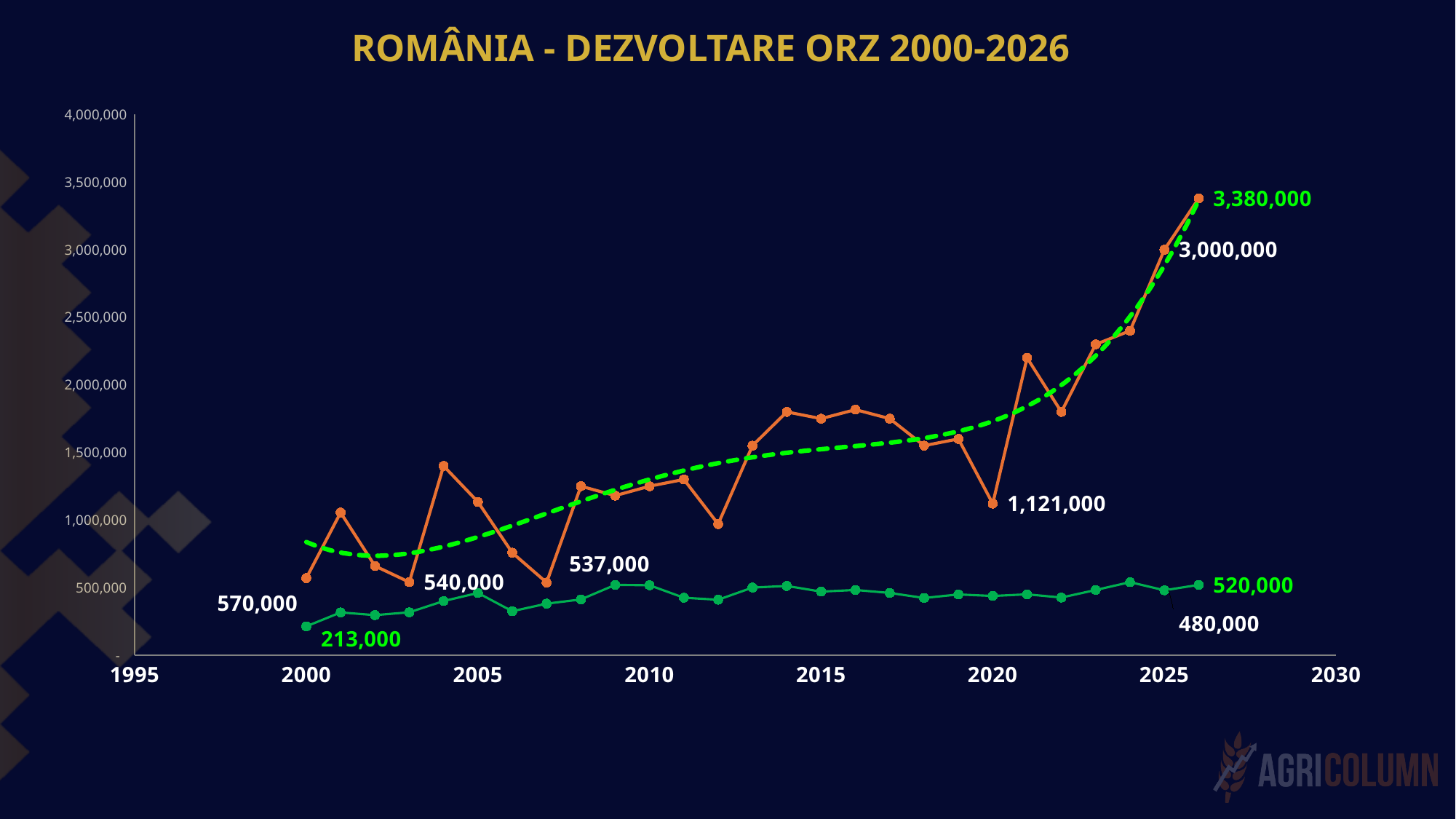
What is the value of the orange line in 2025? 3,000,000 What is the value of the orange line in 2000? 570,000 Is the value of the orange line in 2021 greater or less than 2,000,000? greater What is the value of the green line in 2000? 213,000 What is the value of the green line in 2026? 520,000 What is the difference between the green line's value in 2026 and its value in 2000? 307,000 What kind of chart is shown on the slide? line chart What is the value of the orange line in 2020? 1,121,000 In 2026, which line has the higher value, the orange line or the green line? orange line By how much does the orange line increase from 2025 to 2026? 380,000 What is the title of the chart? ROMÂNIA - DEZVOLTARE ORZ 2000-2026 What is the value of the orange line in 2026? 3,380,000